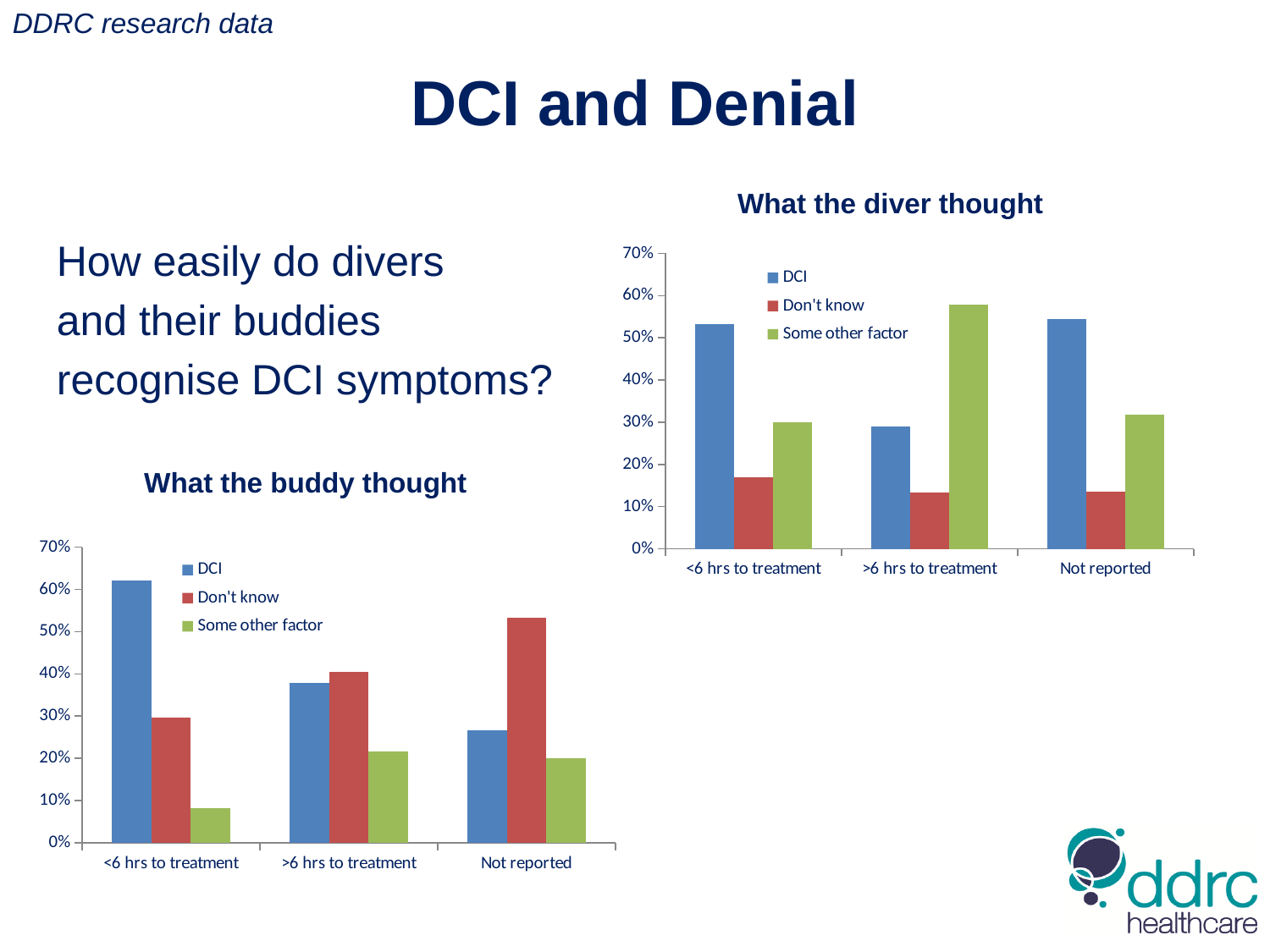
In "What the diver thought", is the DCI value for <6 hrs to treatment greater or less than 50%? greater In "What the buddy thought", which category has the lowest value for Some other factor? <6 hrs to treatment How many categories are shown on the x axis of "What the diver thought"? 3 In "What the buddy thought", does the DCI series rise or fall from <6 hrs to treatment to Not reported? Falls What are the three legend entries in "What the diver thought"? DCI, Don't know, Some other factor How many series does the legend of "What the buddy thought" list? 3 In "What the diver thought", for >6 hrs to treatment, which is larger: DCI or Some other factor? Some other factor In "What the buddy thought", is the Some other factor value for <6 hrs to treatment greater or less than 10%? less What kind of chart is "What the diver thought"? Bar chart In "What the buddy thought", for Not reported, which is larger: DCI or Don't know? Don't know In "What the diver thought", which category has the highest value for Some other factor? >6 hrs to treatment In "What the buddy thought", which category has the highest value for DCI? <6 hrs to treatment